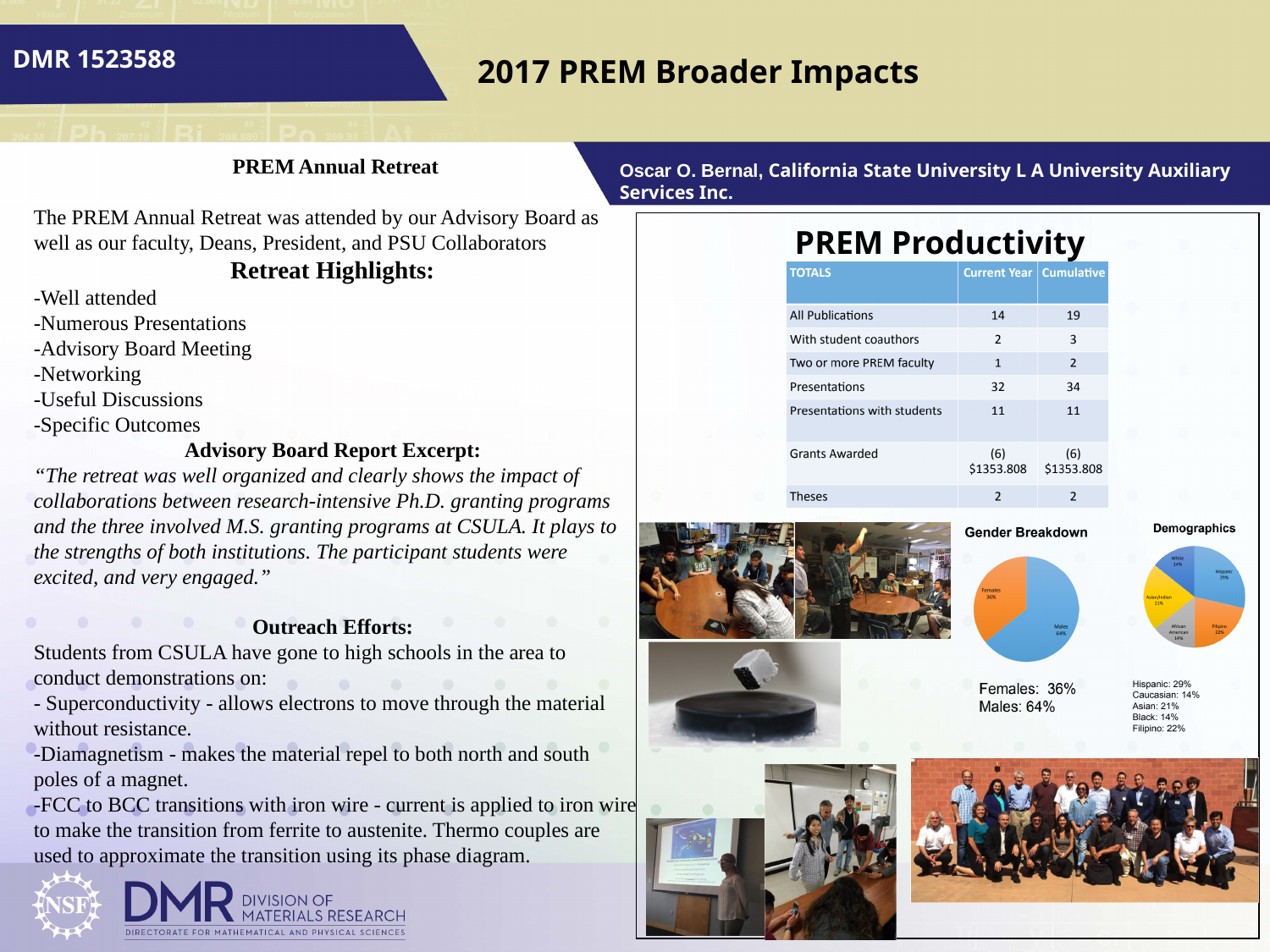
In the Gender Breakdown pie chart, what share is Males? 64% In the Gender Breakdown pie chart, which slice is larger, Females or Males? Males How many groups are shown in the Demographics pie chart? 5 In the Gender Breakdown chart, what is the difference between the Males and Females percentages? 28% In the Demographics pie chart, what share is Asian? 21% What kind of chart is the Gender Breakdown chart? pie chart In the Demographics chart, what is the difference between the Hispanic and Filipino shares? 7% In the Demographics pie chart, which group has the largest share? Hispanic In the Gender Breakdown pie chart, what share is Females? 36% How many slices does the Gender Breakdown pie chart have? 2